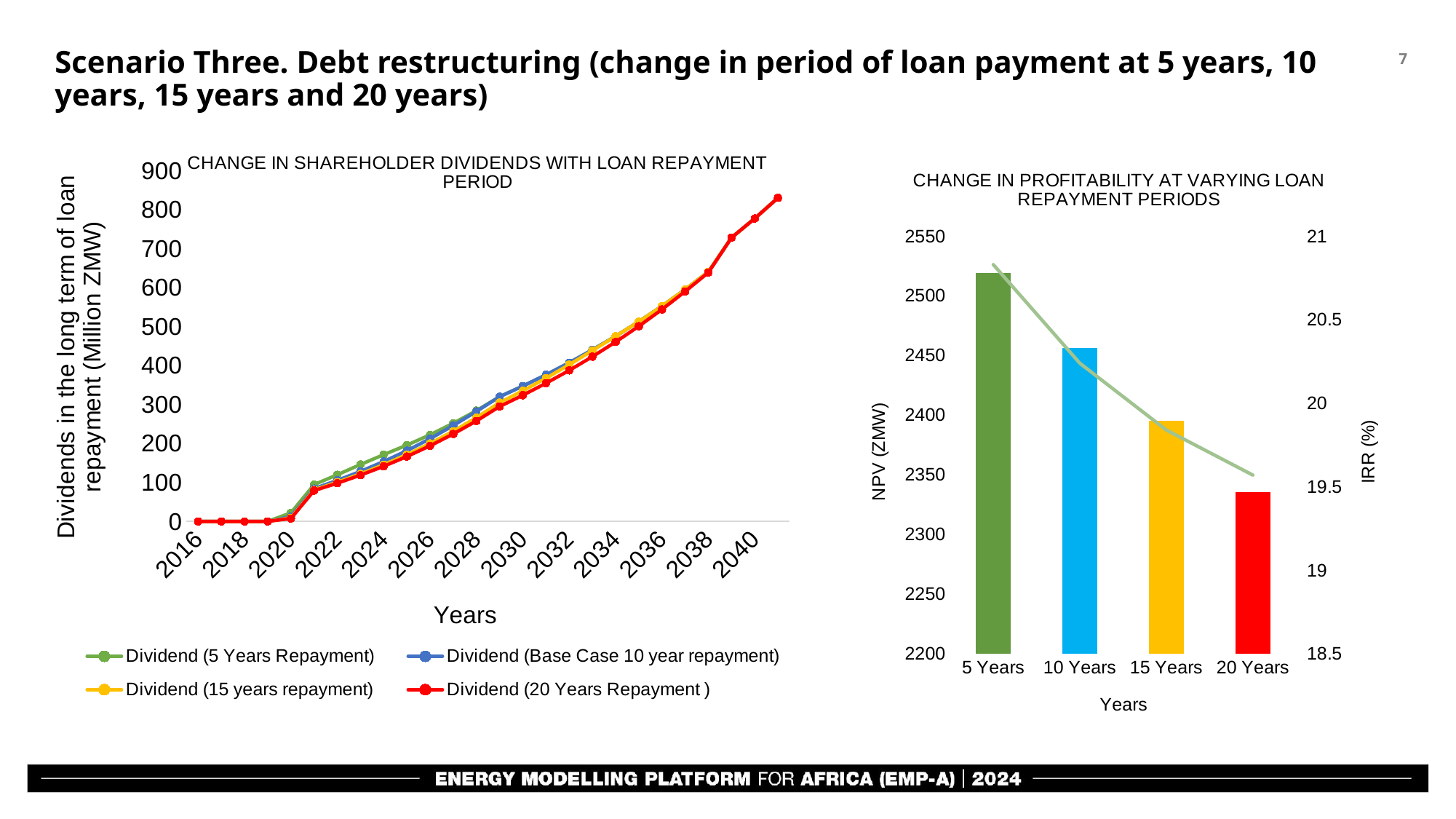
What kind of chart is the 'CHANGE IN SHAREHOLDER DIVIDENDS WITH LOAN REPAYMENT PERIOD' chart? line chart On the 'CHANGE IN PROFITABILITY AT VARYING LOAN REPAYMENT PERIODS' chart, which repayment period has the lowest NPV bar? 20 Years On the 'CHANGE IN PROFITABILITY AT VARYING LOAN REPAYMENT PERIODS' chart, which repayment period has the highest NPV bar? 5 Years On the 'CHANGE IN PROFITABILITY AT VARYING LOAN REPAYMENT PERIODS' chart, is the NPV for 5 Years greater or less than 2500? greater On the 'CHANGE IN SHAREHOLDER DIVIDENDS WITH LOAN REPAYMENT PERIOD' chart, is the Dividend (20 Years Repayment) value at 2040 greater or less than 700? greater On the 'CHANGE IN PROFITABILITY AT VARYING LOAN REPAYMENT PERIODS' chart, is the NPV for 20 Years greater or less than 2300? greater On the 'CHANGE IN PROFITABILITY AT VARYING LOAN REPAYMENT PERIODS' chart, which is larger, the NPV for 10 Years or the NPV for 15 Years? 10 Years On the 'CHANGE IN SHAREHOLDER DIVIDENDS WITH LOAN REPAYMENT PERIOD' chart, do the dividend values rise or fall from 2020 to 2040? rise On the 'CHANGE IN PROFITABILITY AT VARYING LOAN REPAYMENT PERIODS' chart, do the NPV bars rise or fall as the repayment period increases from 5 Years to 20 Years? fall On the 'CHANGE IN PROFITABILITY AT VARYING LOAN REPAYMENT PERIODS' chart, how many repayment period categories are shown on the x axis? 4 On the 'CHANGE IN SHAREHOLDER DIVIDENDS WITH LOAN REPAYMENT PERIOD' chart, how many series does the legend list? 4